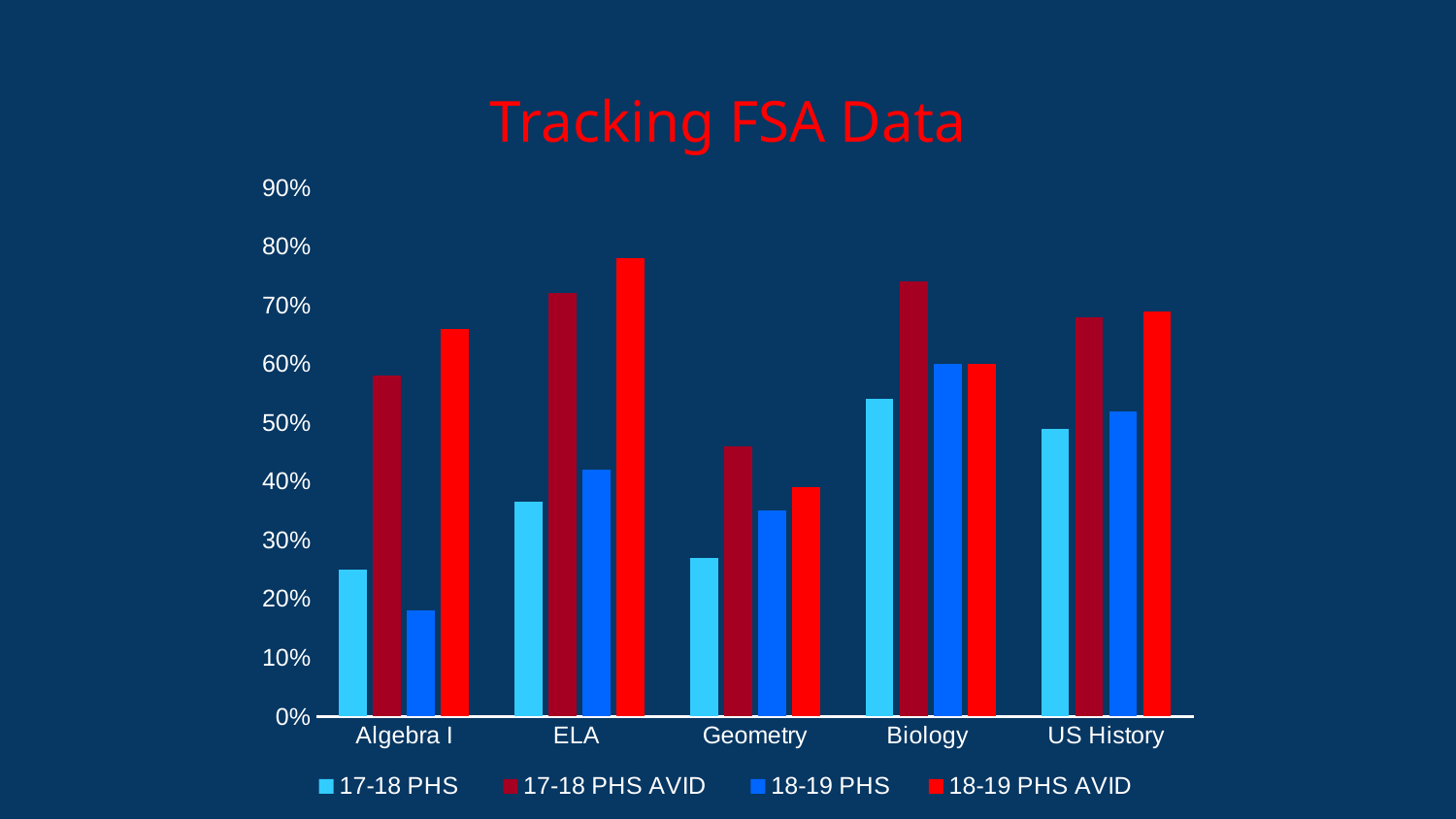
What is the title of the chart? Tracking FSA Data Is the value for 17-18 PHS in Algebra I greater or less than 30%? less Which subject has the highest value for 18-19 PHS AVID? ELA Which subject has the lowest value for 18-19 PHS? Algebra I Is the value for 17-18 PHS AVID in Biology greater or less than 70%? greater How many subject categories are shown on the x axis? 5 Is the value for 18-19 PHS AVID in ELA greater or less than 70%? greater How many series does the legend list? 4 Which subject has the highest value for 17-18 PHS? Biology What kind of chart is shown on the slide? bar chart In Geometry, which is larger: 17-18 PHS AVID or 18-19 PHS AVID? 17-18 PHS AVID In Biology, which is larger: 17-18 PHS or 18-19 PHS? 18-19 PHS